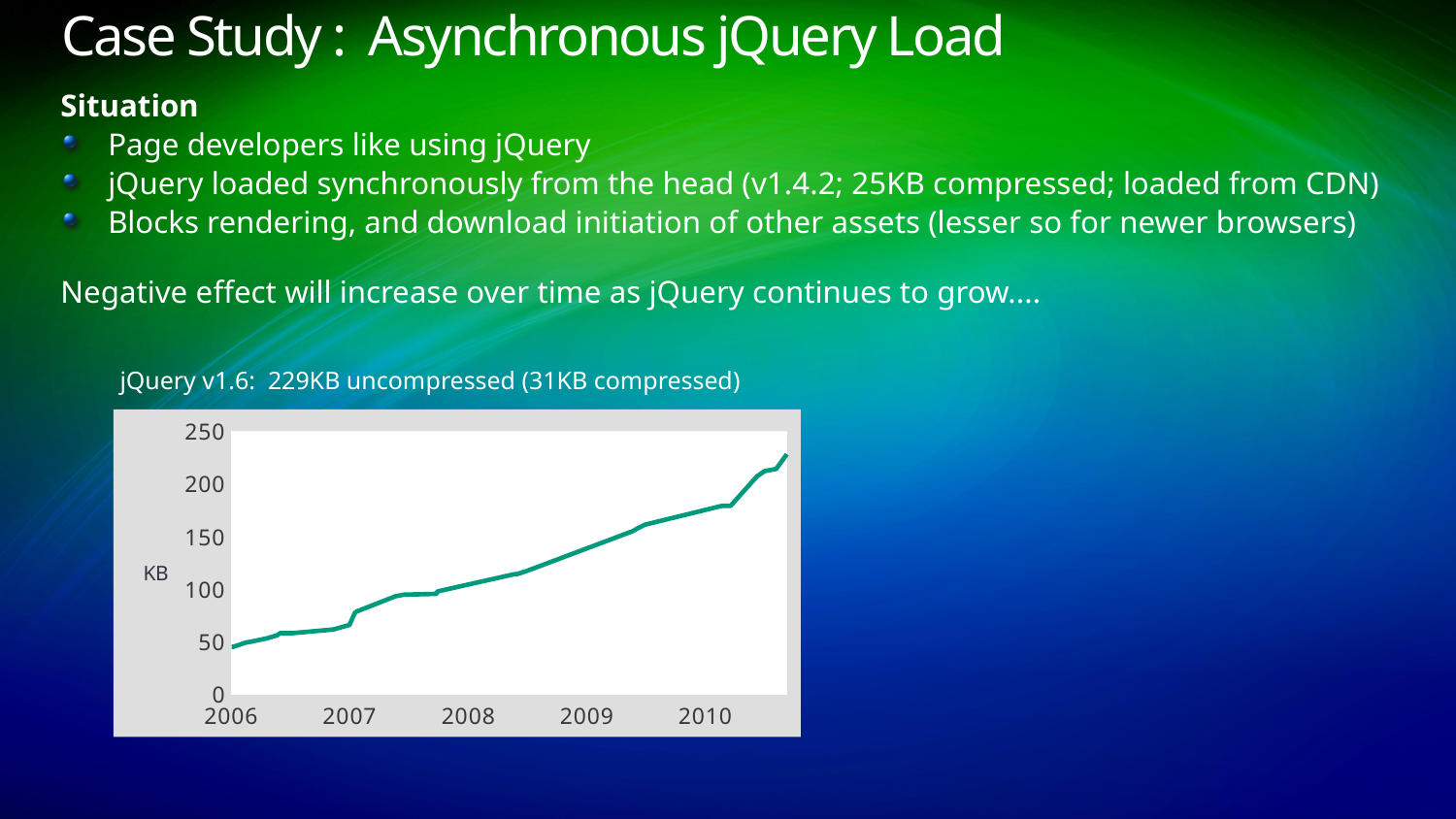
Is the value for 2010 greater or less than 150? greater What is the highest value shown on the y axis of the chart? 250 Is the value for 2010 greater or less than 200? less Is the value for 2009 greater or less than 100? greater Do the values in the chart rise or fall from 2006 to 2010? rise What kind of chart is shown on the slide? line chart What unit is shown on the y axis of the chart? KB How many years are labeled on the x axis of the chart? 5 Which year shown on the x axis has the lowest value? 2006